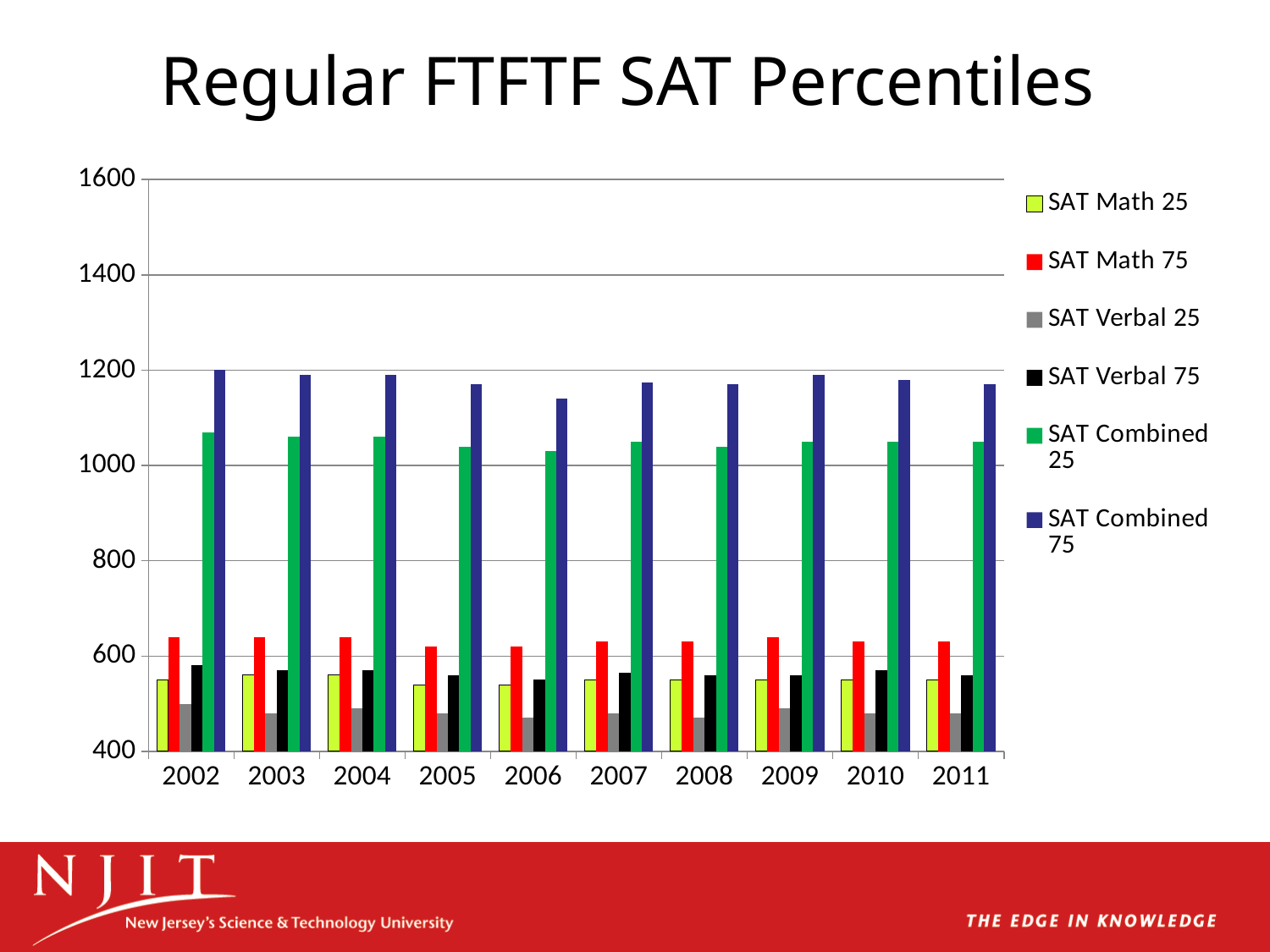
Which is larger, SAT Combined 75 in 2002 or SAT Combined 75 in 2006? SAT Combined 75 in 2002 What kind of chart is shown on the slide? bar chart Is the value for SAT Combined 75 in 2006 greater or less than 1000? greater Which colour represents SAT Math 75 in the legend? red Is the value for SAT Combined 25 in 2006 greater or less than 1200? less How many series does the legend list? 6 Which series has the highest values across all years? SAT Combined 75 Is the value for SAT Verbal 25 in 2002 greater or less than 600? less What is the title of the chart? Regular FTFTF SAT Percentiles How many years are shown along the x axis? 10 In which year is SAT Combined 75 lowest? 2006